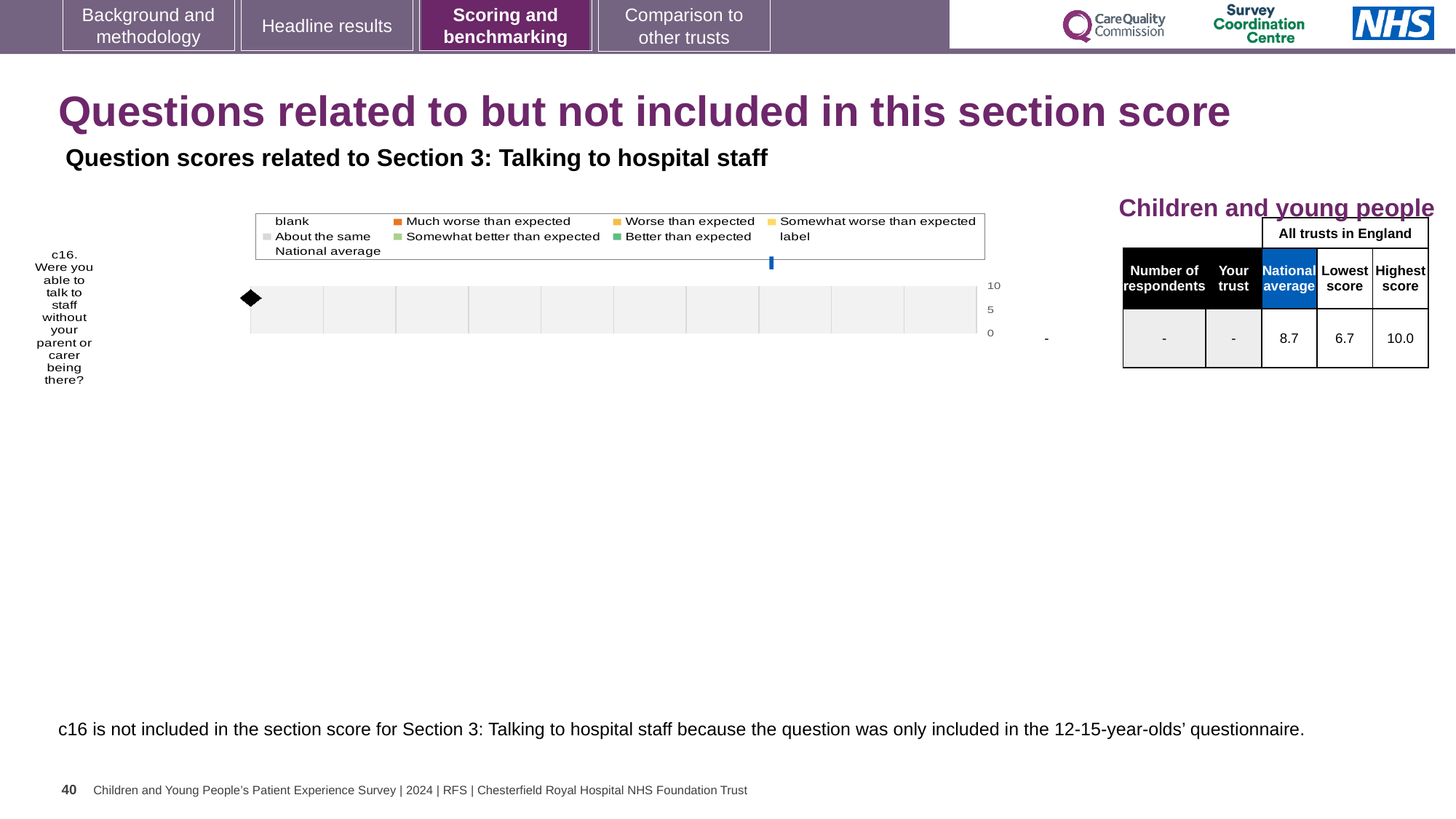
What is the difference between the Highest score and the Lowest score shown in the table for c16? 3.3 How many questions (categories) are plotted on the chart's vertical axis? 1 In the table next to the chart, what is the National average score for c16? 8.7 What value is shown for Your trust in the table for c16? - In the table next to the chart, what is the Highest score across all trusts in England for c16? 10.0 What kind of chart is shown on the slide? bar chart What is the highest tick value shown on the chart's horizontal axis? 10 Which question is plotted on the chart? c16. Were you able to talk to staff without your parent or carer being there? In the table next to the chart, what is the Lowest score across all trusts in England for c16? 6.7 Is the National average score for c16 in the table greater or less than 5? greater Which is larger for c16 in the table: the National average or the Lowest score? National average